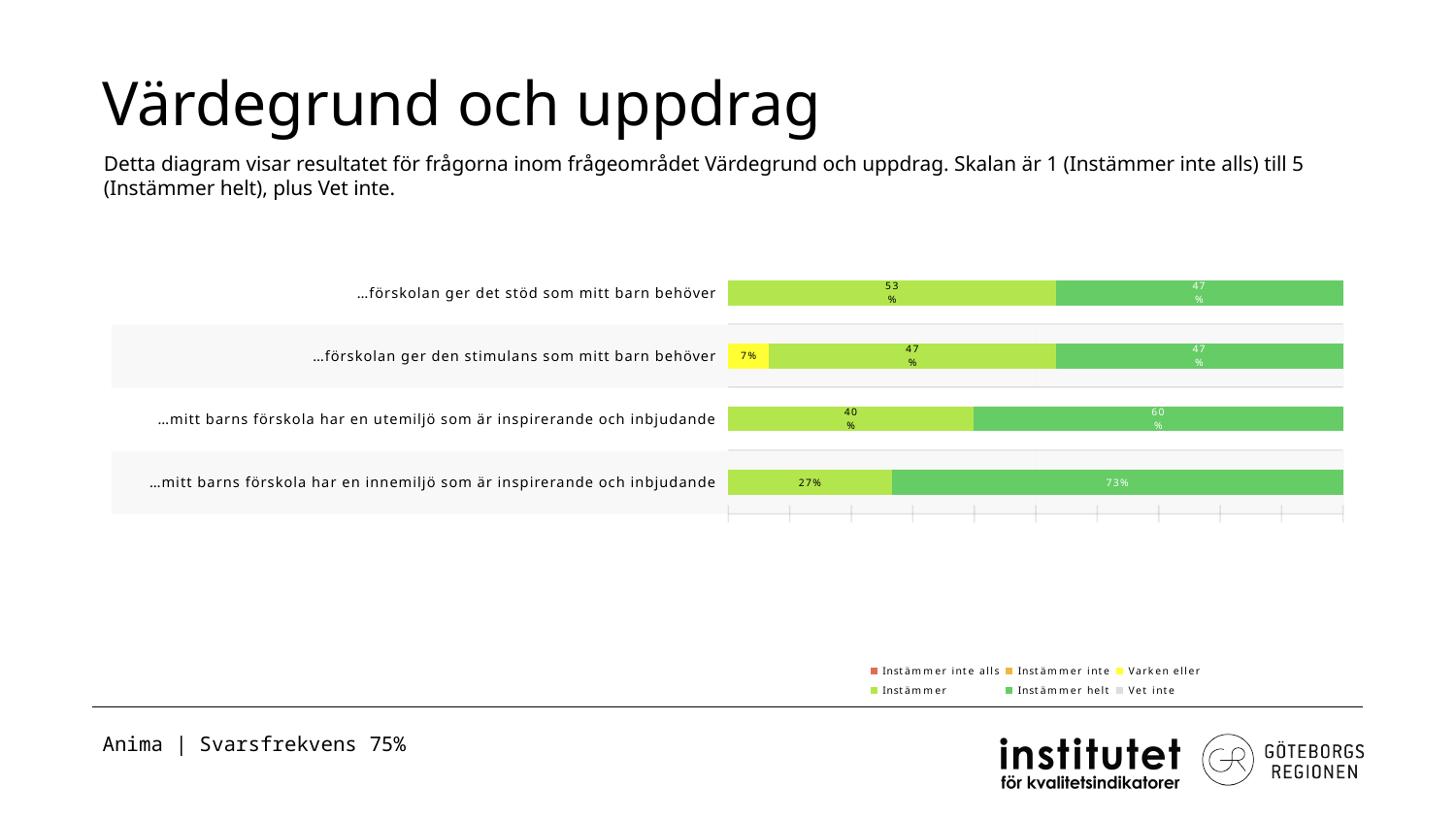
What is the total of the stacked bar for '…förskolan ger det stöd som mitt barn behöver'? 100% What is the 'Instämmer helt' value for '…mitt barns förskola har en innemiljö som är inspirerande och inbjudande'? 73% What kind of chart is shown on the slide? Stacked bar chart How many series does the legend list? 6 Which category has the lowest 'Instämmer' value? …mitt barns förskola har en innemiljö som är inspirerande och inbjudande What is the difference between the 'Instämmer helt' and 'Instämmer' values for '…mitt barns förskola har en innemiljö som är inspirerande och inbjudande'? 46 percentage points What is the 'Instämmer helt' value for '…mitt barns förskola har en utemiljö som är inspirerande och inbjudande'? 60% What is the 'Instämmer' value for '…förskolan ger det stöd som mitt barn behöver'? 53% What is the 'Varken eller' value for '…förskolan ger den stimulans som mitt barn behöver'? 7% Which category has the highest 'Instämmer helt' value? …mitt barns förskola har en innemiljö som är inspirerande och inbjudande How many categories (questions) are plotted in the chart? 4 Which is larger: the 'Instämmer helt' value for the utemiljö question or the 'Instämmer helt' value for the stöd question? The utemiljö question (60%)